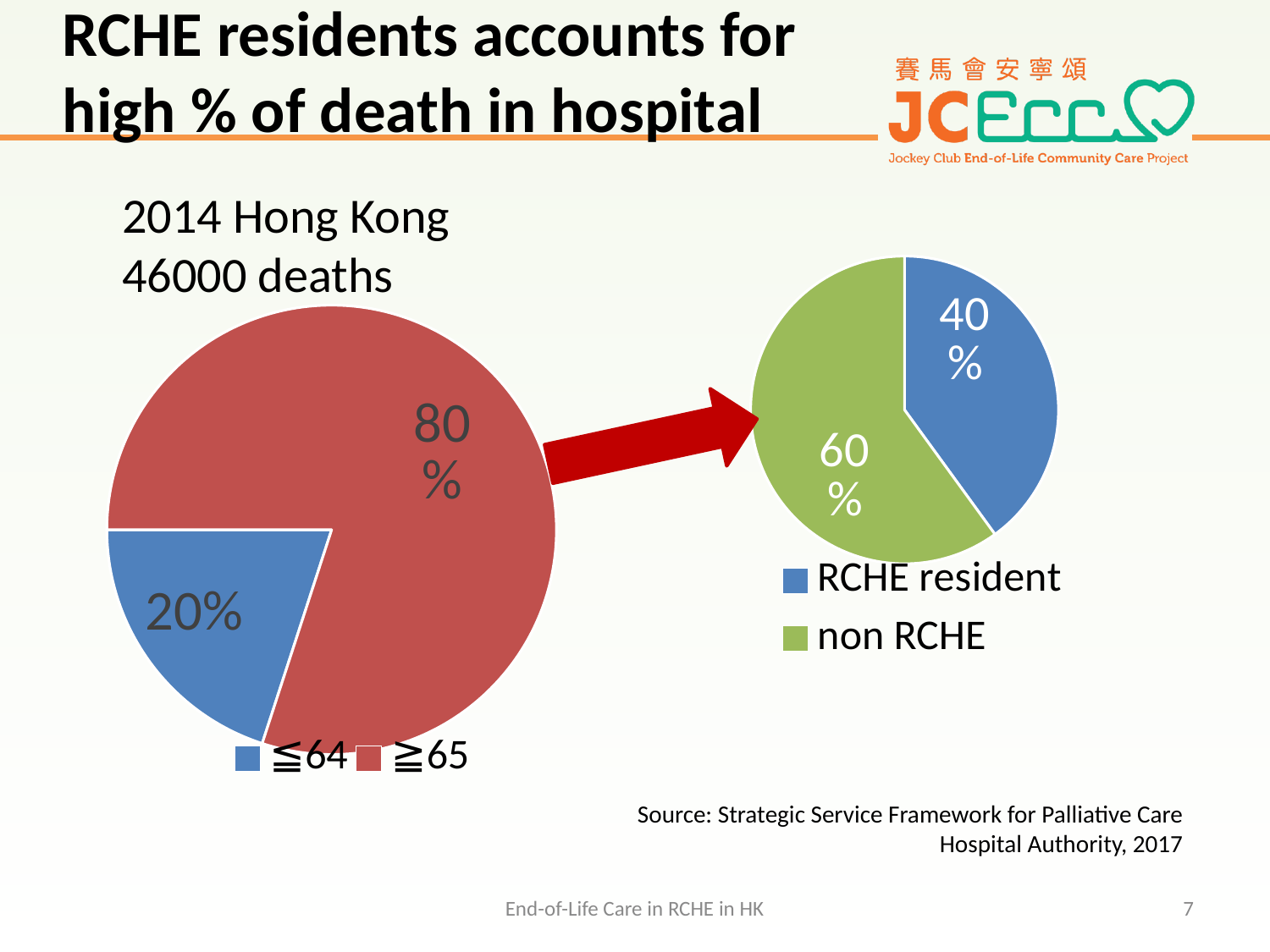
On the right pie chart, what share is labelled for non RCHE? 60% On the left pie chart, which category has the largest share? ≧65 On the left pie chart, what colour is the ≦64 slice? Blue On the right pie chart, which is larger: RCHE resident or non RCHE? non RCHE On the right pie chart, what is the difference in percentage points between non RCHE and RCHE resident? 20 On the left pie chart, what share of deaths is for the ≦64 category? 20% On the right pie chart, what share is labelled for RCHE resident? 40% What type of chart is used on the left of the slide? Pie chart On the left pie chart, what share of deaths is for the ≧65 category? 80% How many categories does the legend of the right pie chart list? 2 On the right pie chart, which category has the smallest share? RCHE resident On the left pie chart, what is the difference in percentage points between the ≧65 and ≦64 shares? 60